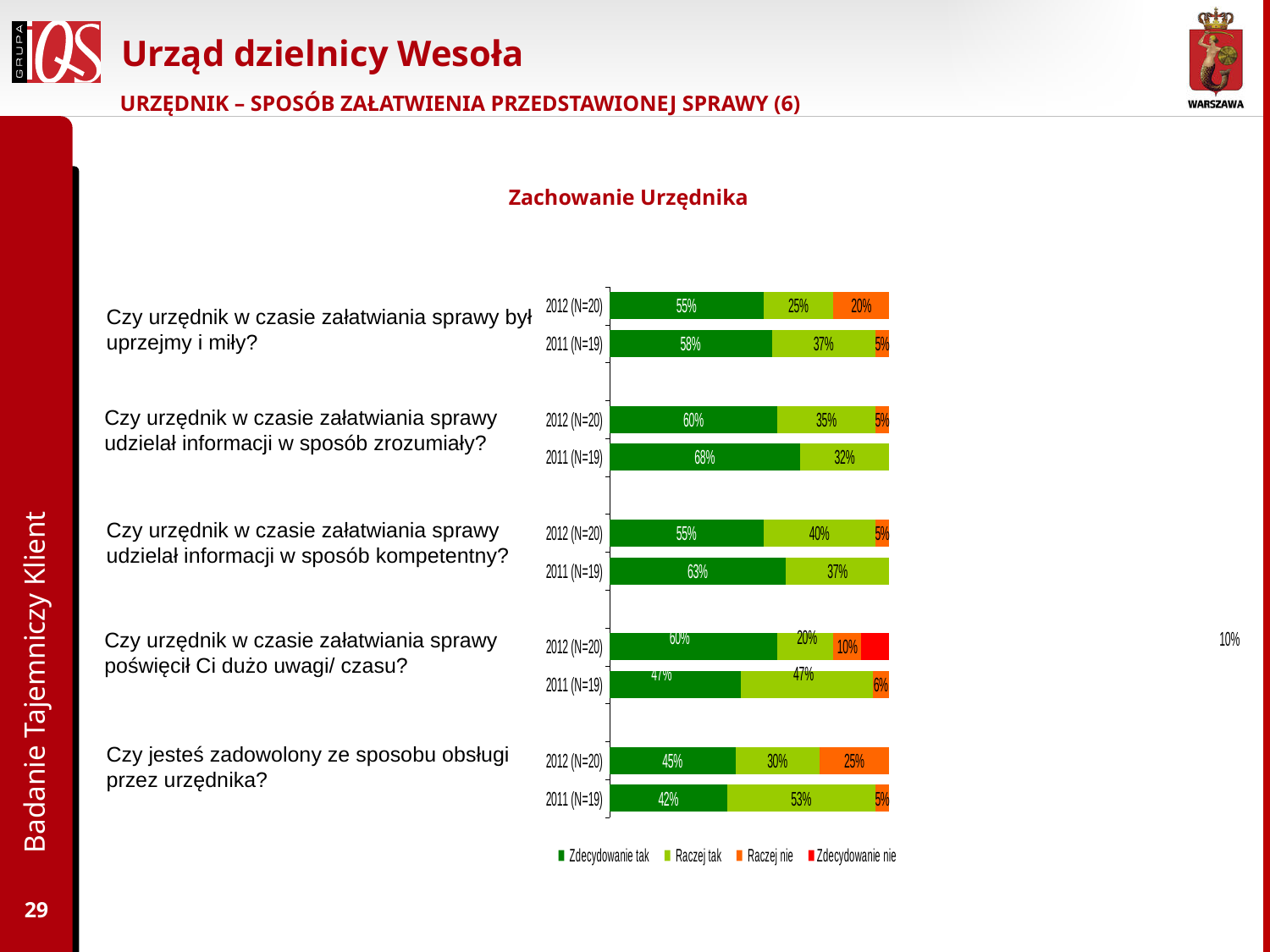
What is the title of the chart? Zachowanie Urzędnika For the question 'Czy urzędnik w czasie załatwiania sprawy był uprzejmy i miły?', is the 'Raczej tak' value larger in 2012 (N=20) or 2011 (N=19)? 2011 (N=19) What type of chart is shown on the slide? stacked bar chart What is the 'Zdecydowanie tak' value for 2012 (N=20) for the question 'Czy urzędnik w czasie załatwiania sprawy był uprzejmy i miły?'? 55% Which bar has the lowest 'Zdecydowanie tak' value? 2011 (N=19) for 'Czy jesteś zadowolony ze sposobu obsługi przez urzędnika?' For the question 'Czy urzędnik w czasie załatwiania sprawy udzielał informacji w sposób kompetentny?', what is the difference between the 'Zdecydowanie tak' values for 2011 (N=19) and 2012 (N=20)? 8% What is the 'Raczej nie' value for 2011 (N=19) for the question 'Czy urzędnik w czasie załatwiania sprawy poświęcił Ci dużo uwagi/ czasu?'? 6% Which bar has the highest 'Zdecydowanie tak' value? 2011 (N=19) for 'Czy urzędnik w czasie załatwiania sprawy udzielał informacji w sposób zrozumiały?' What is the 'Raczej tak' value for 2011 (N=19) for the question 'Czy jesteś zadowolony ze sposobu obsługi przez urzędnika?'? 53% What is the 'Raczej nie' value for 2012 (N=20) for the question 'Czy jesteś zadowolony ze sposobu obsługi przez urzędnika?'? 25% How many bars are plotted in the chart? 10 How many series does the chart legend list? 4